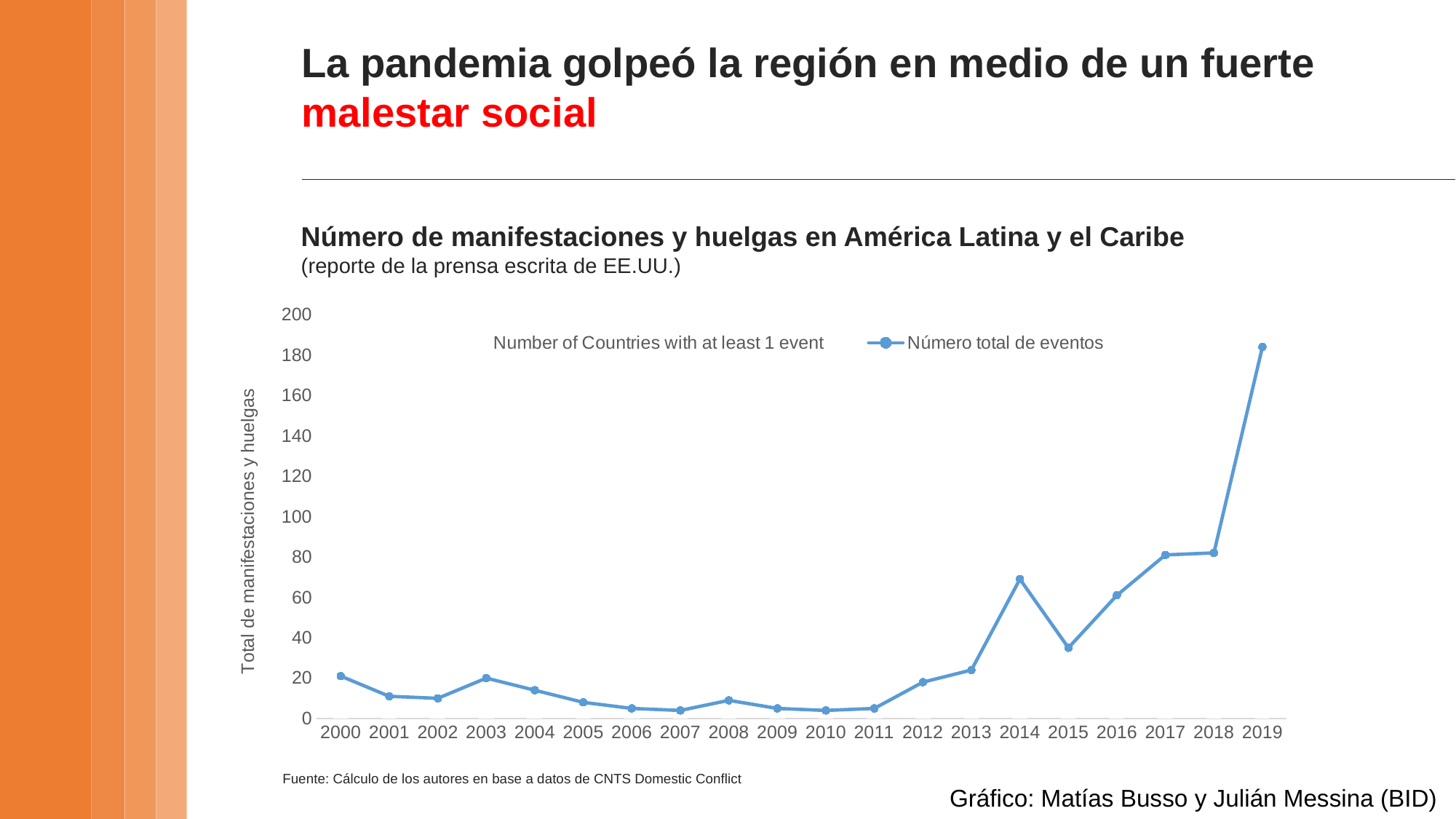
Is the value for 2007 greater or less than 20? less Do the values rise or fall from 2015 to 2019? rise Which year has the larger value, 2014 or 2015? 2014 What kind of chart is shown on the slide? line chart Is the value for 2014 greater or less than 60? greater How many series does the chart's legend list? 2 What is the label of the chart's vertical axis? Total de manifestaciones y huelgas Is the value for 2017 greater or less than 60? greater Which year has the highest number of events in the chart? 2019 How many years are plotted along the x axis of the chart? 20